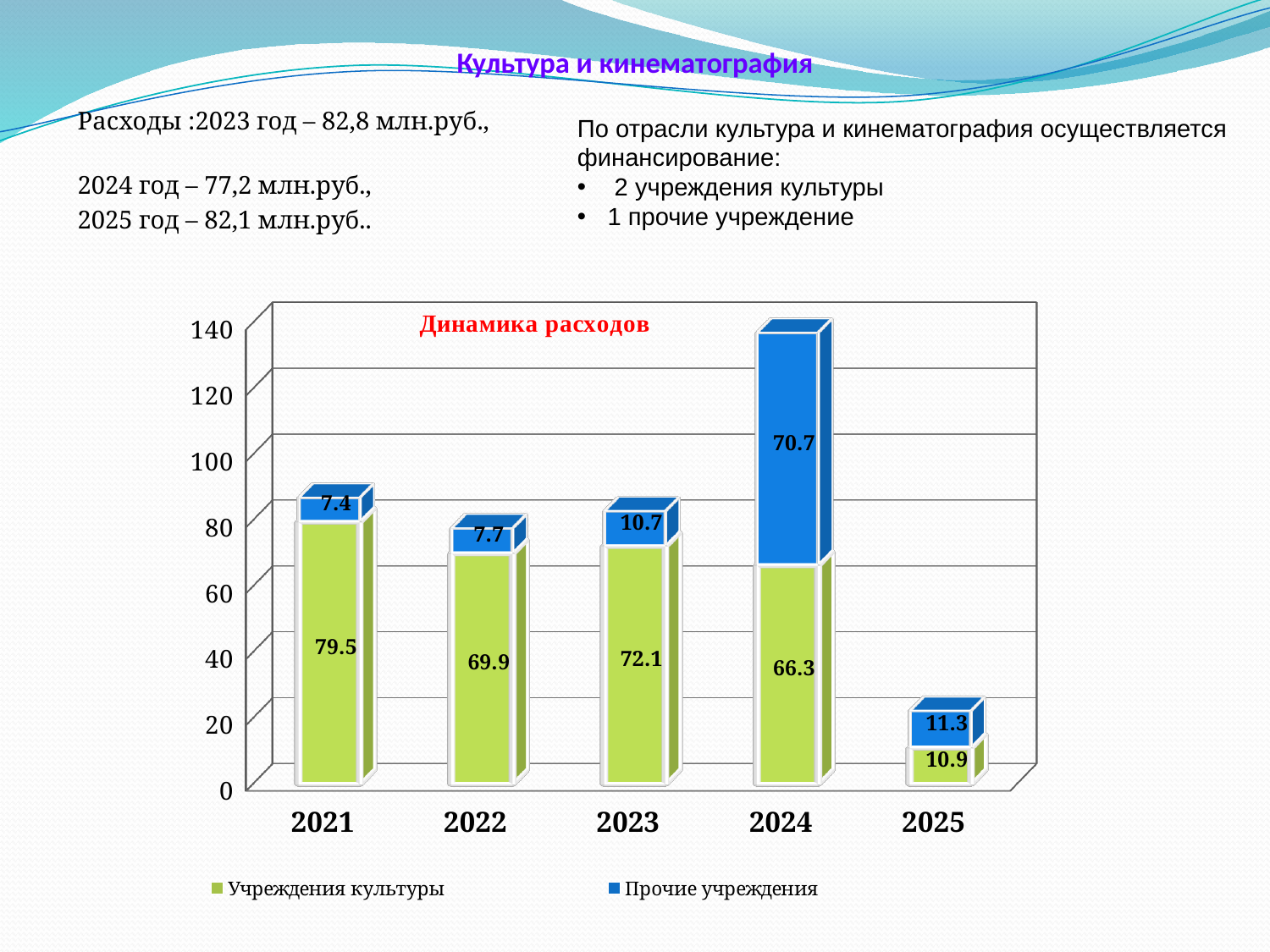
Which year has the highest value for Прочие учреждения? 2024 What is the value for Прочие учреждения in 2024? 70.7 What is the total of the stacked bar for 2023? 82.8 How many series does the legend list? 2 How many years are shown on the x axis? 5 Which is larger: Учреждения культуры in 2023 or Учреждения культуры in 2024? 2023 What is the value for Учреждения культуры in 2021? 79.5 What is the value for Прочие учреждения in 2025? 11.3 Which year has the highest value for Учреждения культуры? 2021 Which year has the lowest value for Учреждения культуры? 2025 What is the difference between the Учреждения культуры values for 2021 and 2022? 9.6 What is the total of the stacked bar for 2024? 137.0